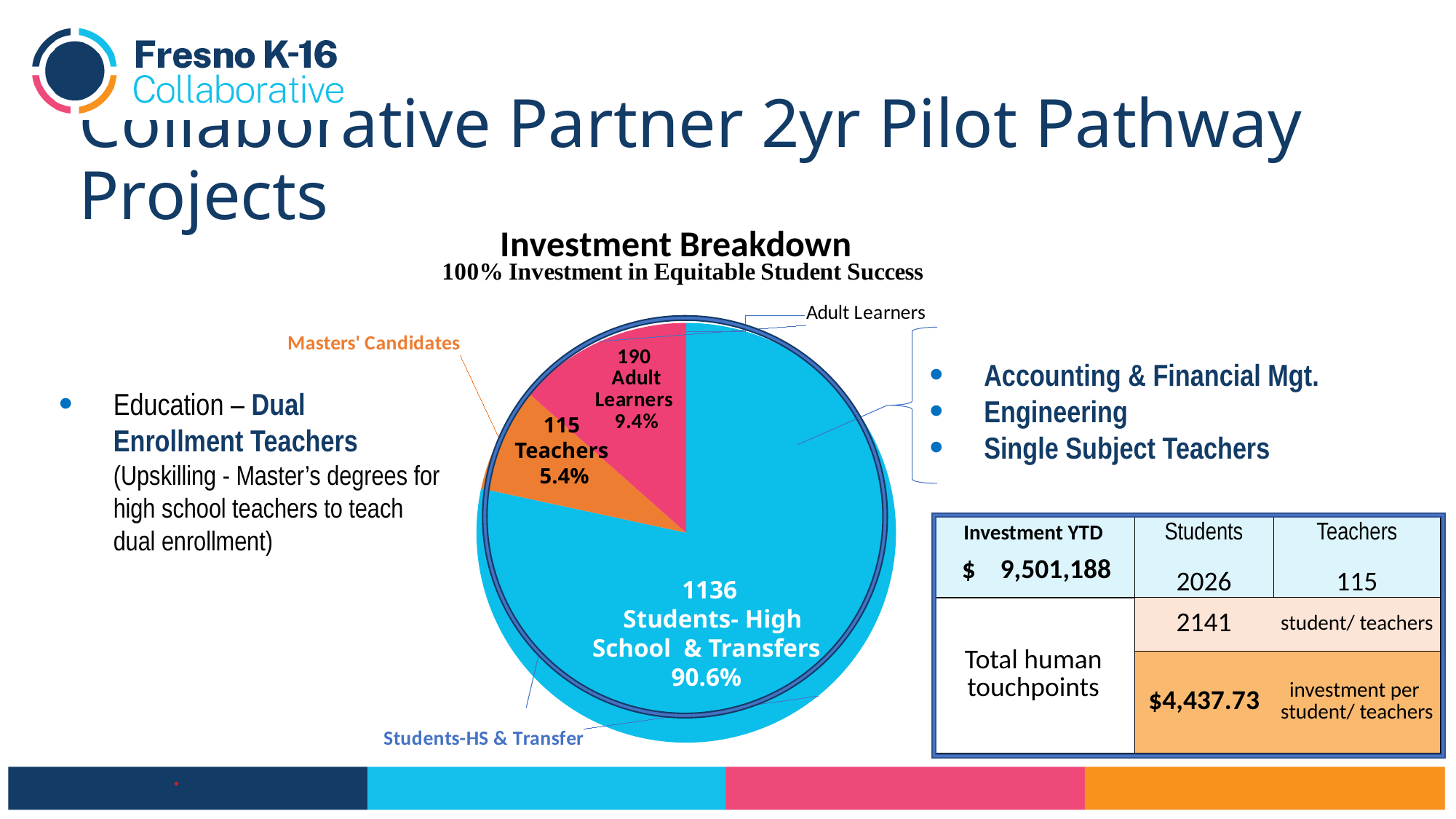
What is the value shown for the Students- High School & Transfers slice in the Investment Breakdown pie chart? 1136 How many slices does the Investment Breakdown pie chart have? 3 What is the value shown for the Adult Learners slice in the Investment Breakdown pie chart? 190 What is the subtitle shown under the Investment Breakdown chart title? 100% Investment in Equitable Student Success What is the value shown for the Teachers slice in the Investment Breakdown pie chart? 115 What percentage share is labelled on the Teachers slice of the Investment Breakdown pie chart? 5.4% Which slice of the Investment Breakdown pie chart is the smallest? Teachers In the Investment Breakdown pie chart, what is the difference between the Adult Learners value and the Teachers value? 75 Which slice of the Investment Breakdown pie chart is the largest? Students- High School & Transfers What kind of chart is the Investment Breakdown chart? pie chart What percentage share is labelled on the Students- High School & Transfers slice of the Investment Breakdown pie chart? 90.6% What percentage share is labelled on the Adult Learners slice of the Investment Breakdown pie chart? 9.4%